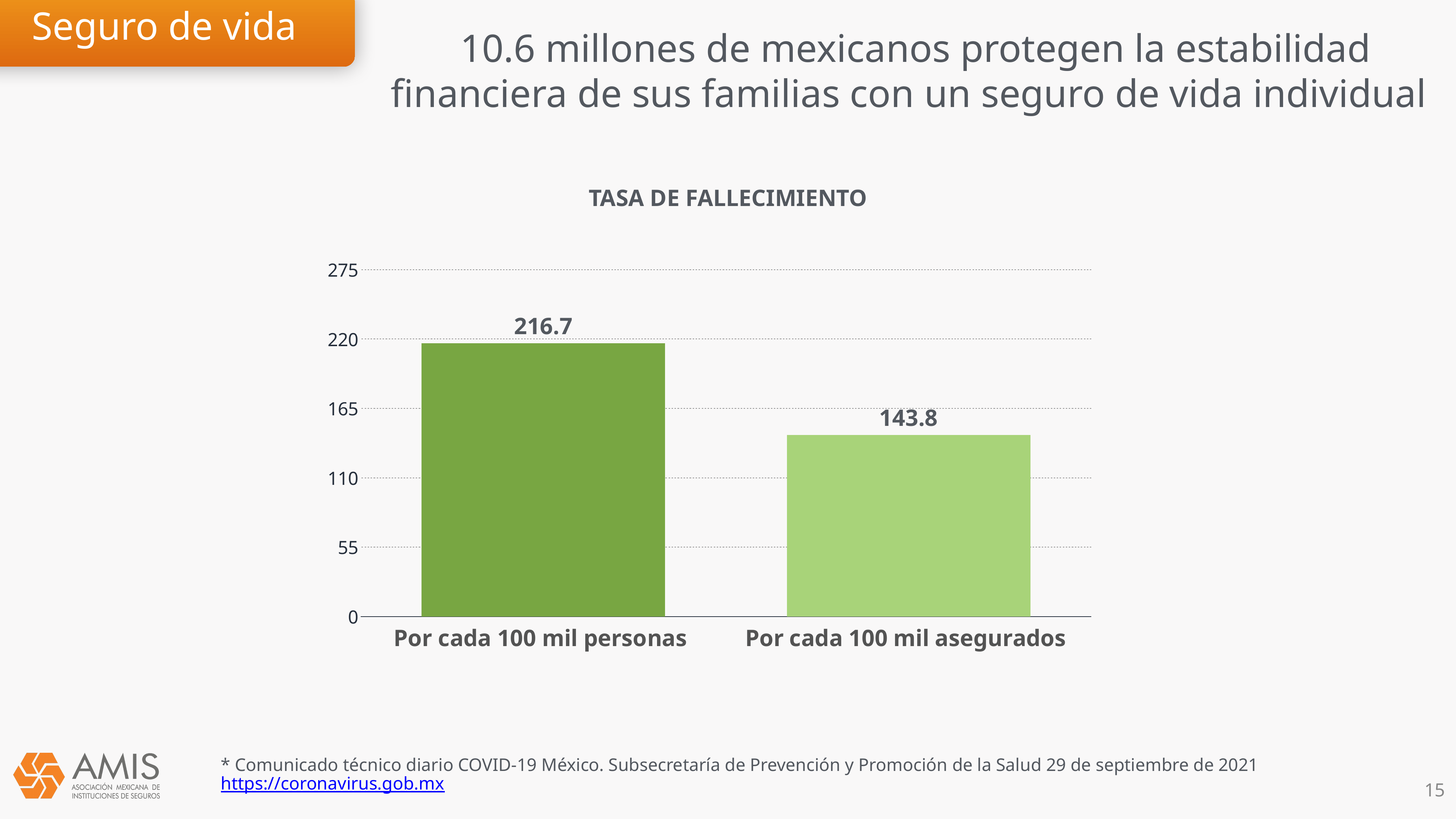
How many categories are shown in the chart? 2 What is the highest value shown on the vertical axis? 275 Is the value for "Por cada 100 mil personas" greater or less than 220? less Which is larger: the value for "Por cada 100 mil personas" or the value for "Por cada 100 mil asegurados"? Por cada 100 mil personas Which category has the lowest value? Por cada 100 mil asegurados What is the title of the chart? TASA DE FALLECIMIENTO Is the value for "Por cada 100 mil asegurados" greater or less than 165? less What is the value for "Por cada 100 mil asegurados"? 143.8 What kind of chart is shown on the slide? bar chart What is the value for "Por cada 100 mil personas"? 216.7 What is the difference between the value for "Por cada 100 mil personas" and the value for "Por cada 100 mil asegurados"? 72.9 Which category has the highest value? Por cada 100 mil personas